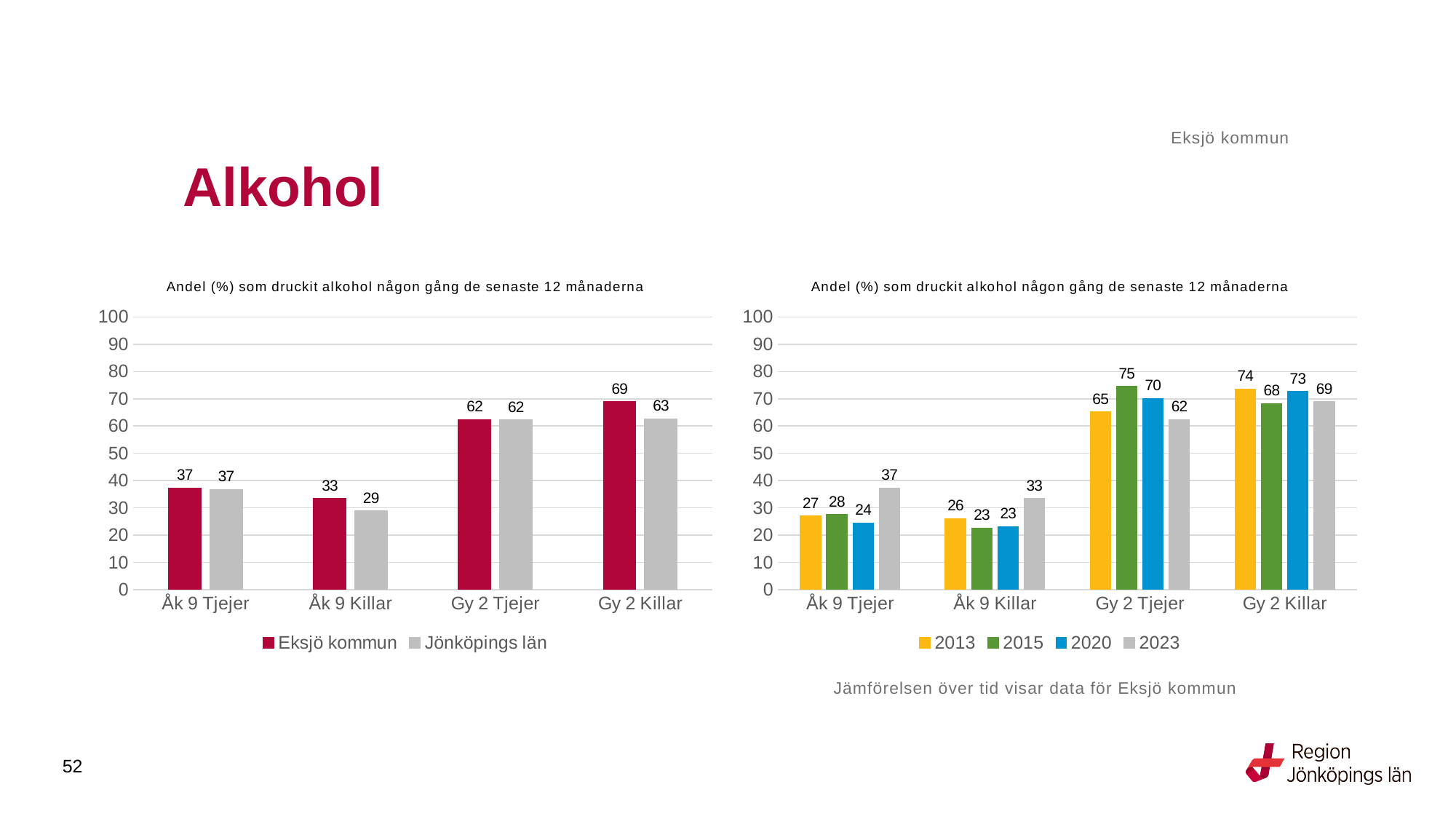
In the left chart, how many series does the legend list? 2 In the left chart, what is the value for Eksjö kommun for Gy 2 Killar? 69 In the right chart, what is the value for 2023 for Åk 9 Tjejer? 37 In the right chart, is the value for 2013 for Gy 2 Killar larger than the value for 2015 for Gy 2 Killar? Yes In the right chart, what is the value for 2015 for Gy 2 Tjejer? 75 In the right chart, how many series does the legend list? 4 In the left chart, which category has the highest value for Eksjö kommun? Gy 2 Killar In the left chart, what is the value for Jönköpings län for Åk 9 Killar? 29 In the right chart, what is the difference between the 2013 and 2023 values for Gy 2 Killar? 5 In the left chart, what is the difference between Eksjö kommun and Jönköpings län for Åk 9 Killar? 4 What kind of chart is the right chart? Bar chart In the right chart, which year has the lowest value for Åk 9 Tjejer? 2020